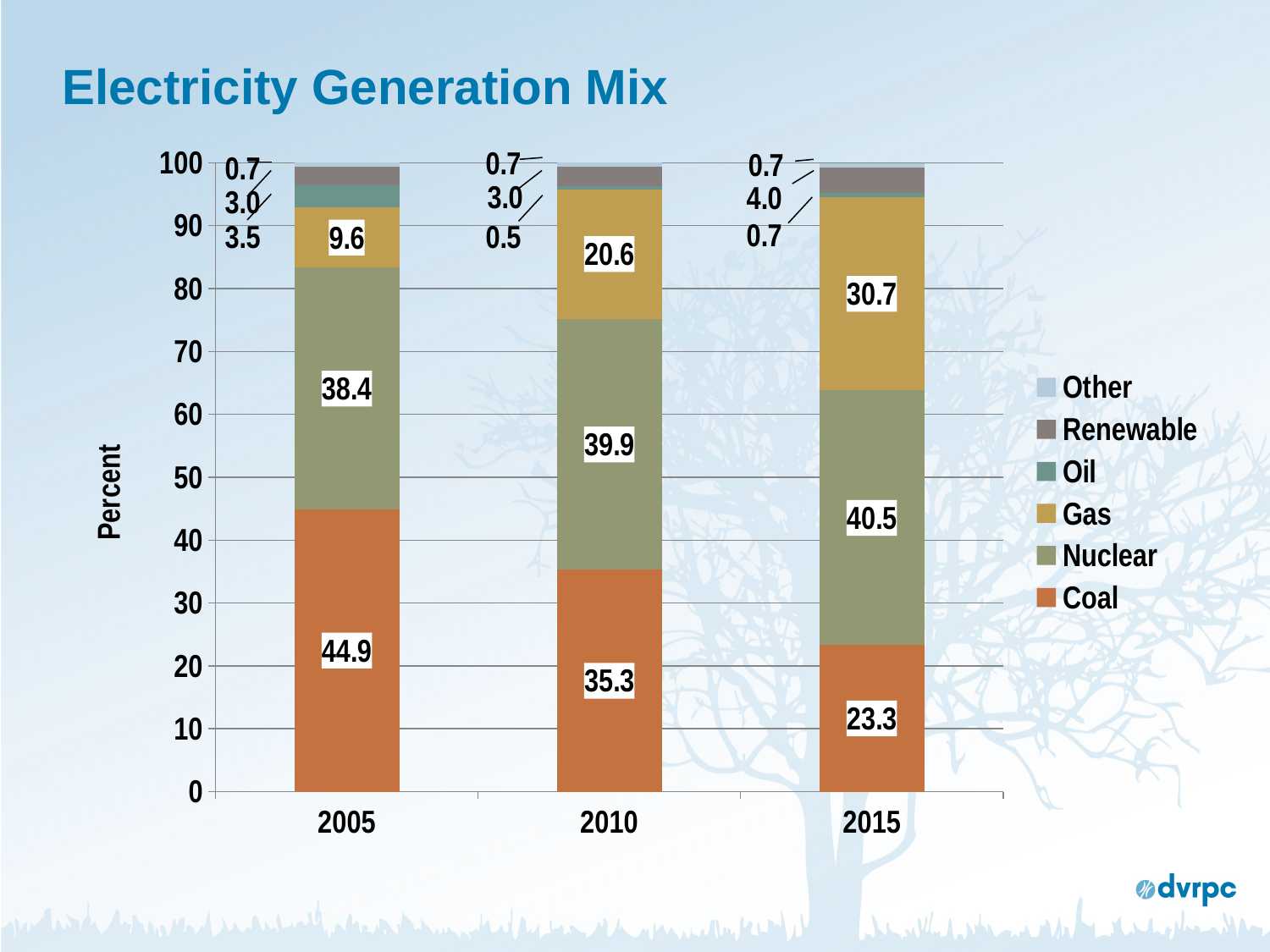
What is the value for Renewable in 2015? 4.0 Does the Coal share rise or fall from 2005 to 2015? Fall What kind of chart is shown on the slide? Stacked bar chart What is the value for Coal in 2005? 44.9 In which year is the Coal share highest? 2005 How many years are shown on the x axis? 3 How many series does the legend list? 6 In 2015, which is larger, Nuclear or Coal? Nuclear What is the difference between the Gas value in 2015 and the Gas value in 2005? 21.1 What is the value for Gas in 2015? 30.7 What is the value for Nuclear in 2010? 39.9 In which year is the Gas share lowest? 2005